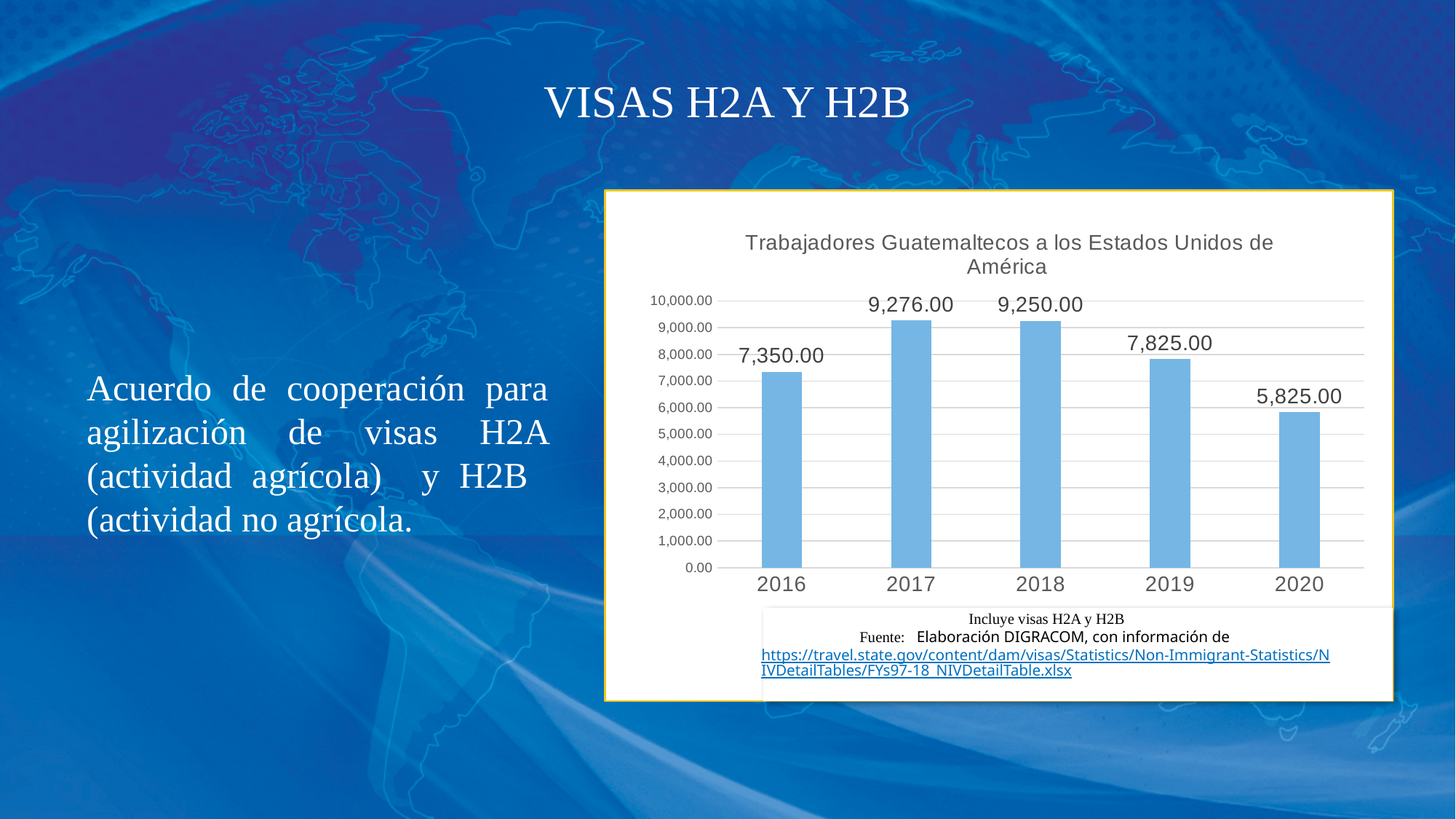
What is the value for 2019? 7,825.00 Which year has the highest value? 2017 Is the value for 2018 greater or less than 9,000.00? greater Which year has the lowest value? 2020 What is the difference between the values for 2019 and 2020? 2,000.00 What is the value for 2016? 7,350.00 What is the value for 2020? 5,825.00 How many years are shown on the x axis? 5 What is the title of the chart? Trabajadores Guatemaltecos a los Estados Unidos de América What is the difference between the values for 2017 and 2018? 26.00 Which is larger, the value for 2016 or the value for 2019? 2019 What kind of chart is shown? bar chart